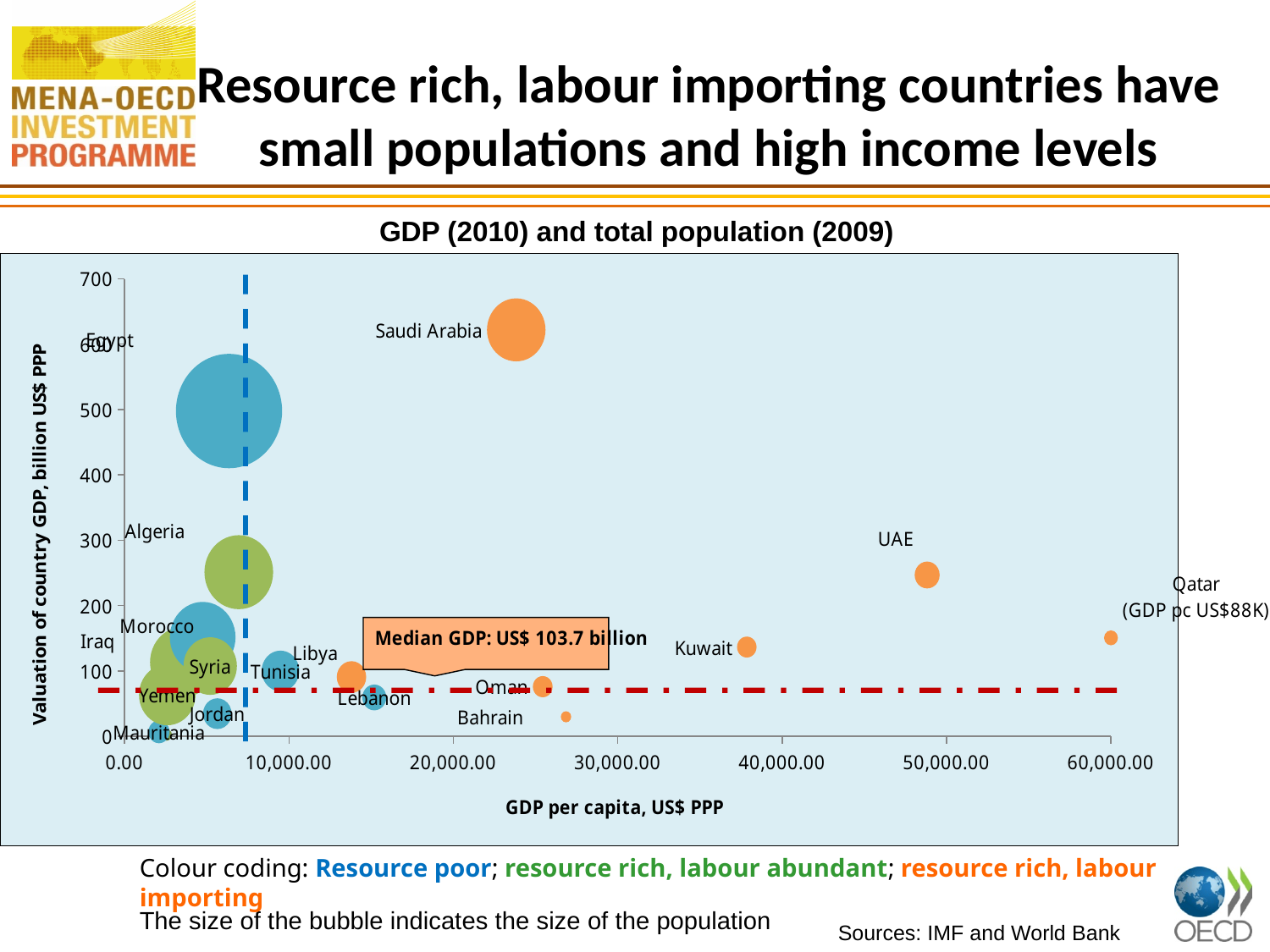
Is the GDP value for Kuwait greater or less than 200? less According to the colour coding, what do the orange bubbles represent? resource rich, labour importing Is the GDP value for Saudi Arabia greater or less than 500? greater What median GDP value is printed in the callout box on the chart? US$ 103.7 billion Is the GDP per capita for UAE greater or less than 40,000.00? greater What GDP per capita is given for Qatar in its label? US$88K What kind of chart is shown on the slide? bubble chart Which has the larger GDP, Egypt or Algeria? Egypt Which country has the highest GDP (y axis) on the chart? Saudi Arabia Which country has the highest GDP per capita (x axis) on the chart? Qatar What is the title of the chart? GDP (2010) and total population (2009)